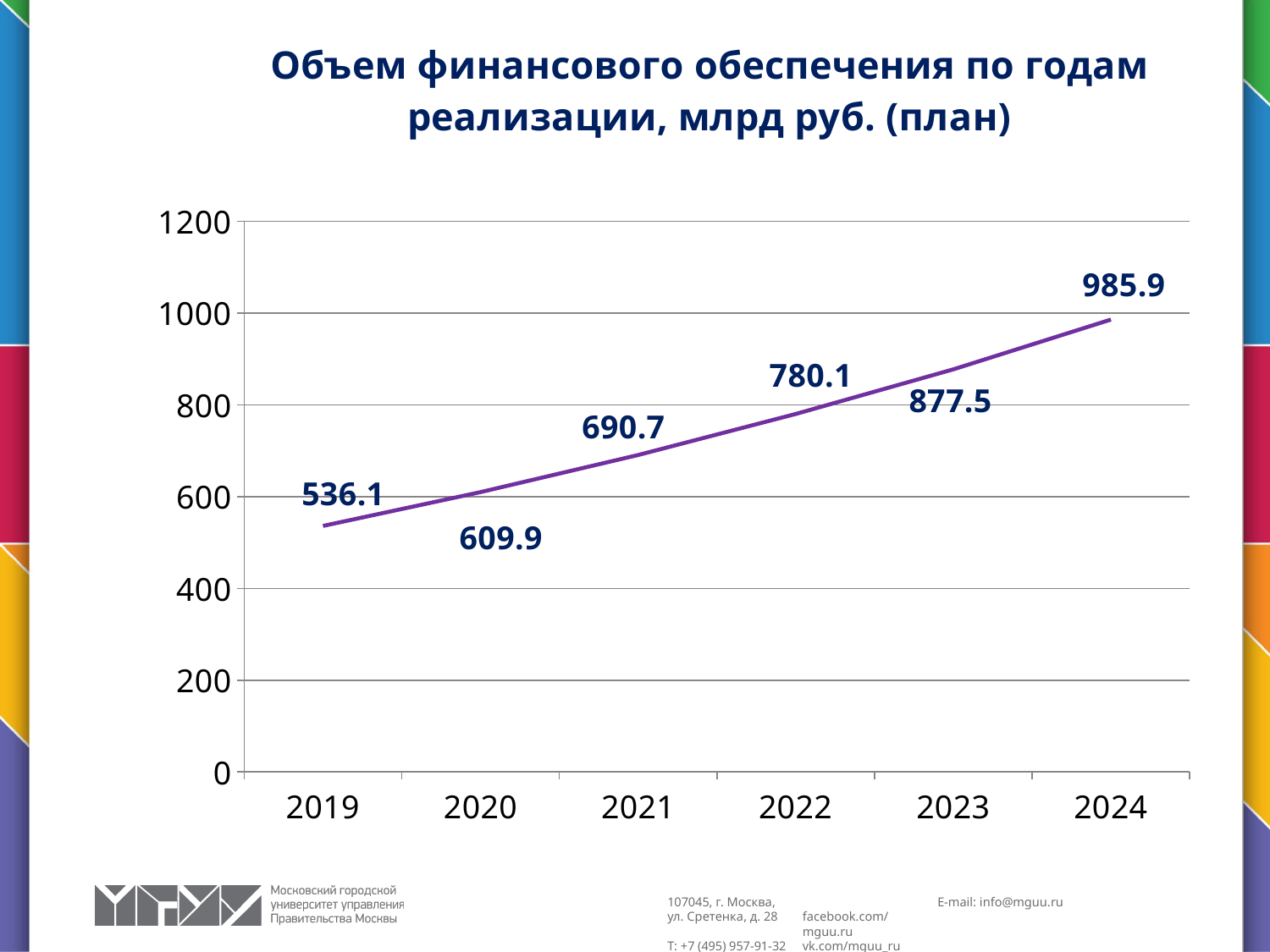
Which year has the lowest value? 2019 Do the values rise or fall from 2019 to 2024? rise What is the difference between the values for 2024 and 2019? 449.8 Which year has the highest value? 2024 How many years are plotted on the chart? 6 What is the value for 2022? 780.1 What is the difference between the values for 2021 and 2020? 80.8 Which is larger, the value for 2023 or the value for 2022? 2023 What is the value for 2019? 536.1 What kind of chart is shown on the slide? line chart What is the value for 2024? 985.9 Is the value for 2023 greater or less than 800? greater